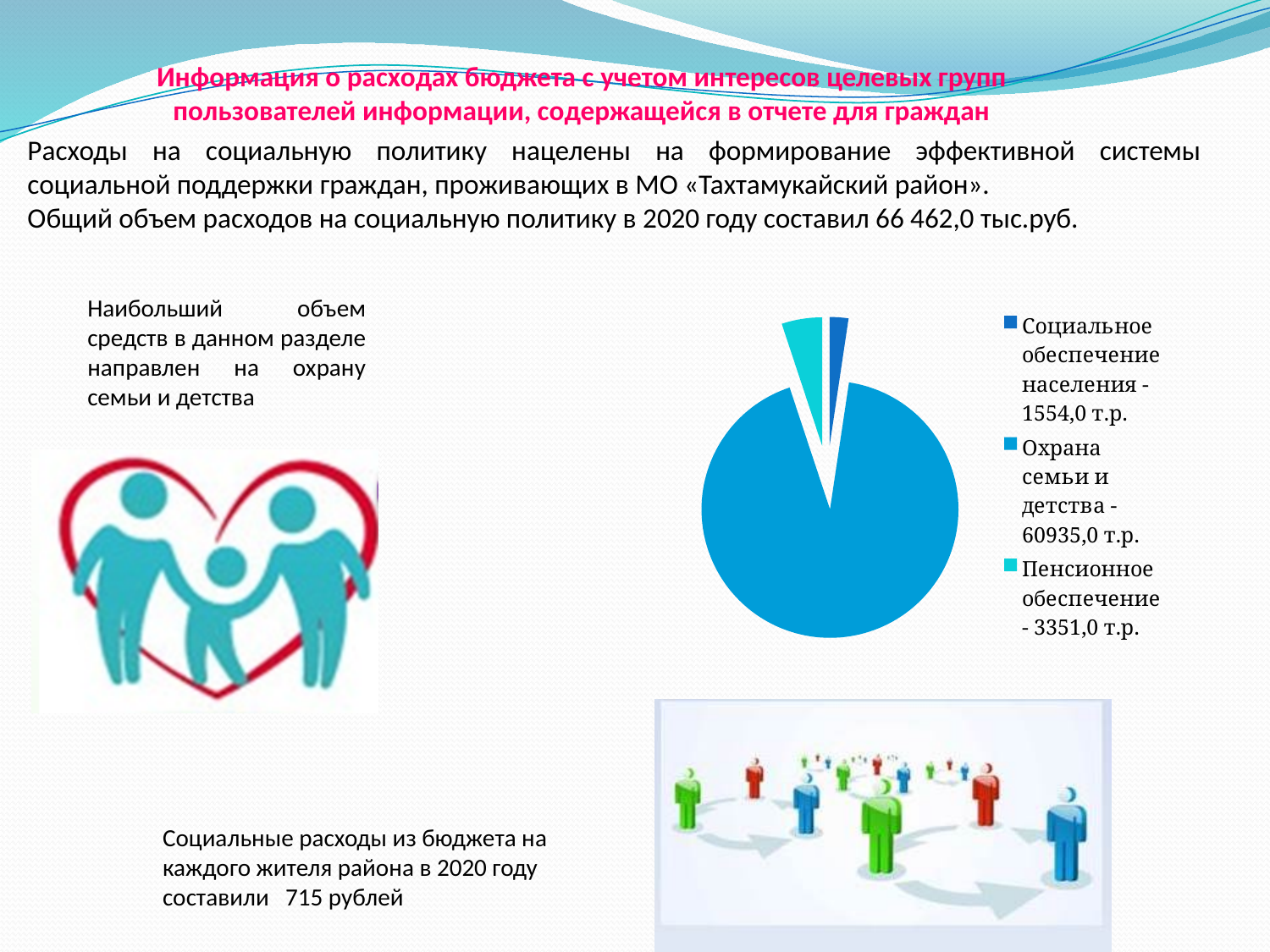
What value does the legend give for Социальное обеспечение населения? 1554,0 т.р. Which category has the smallest slice of the pie chart? Социальное обеспечение населения What is the difference between Пенсионное обеспечение and Социальное обеспечение населения? 1797,0 т.р. How many entries does the legend of the pie chart list? 3 What kind of chart is shown on the slide? pie chart Which category has the largest slice of the pie chart? Охрана семьи и детства What colour is the slice for Пенсионное обеспечение in the pie chart? light blue (cyan) How many slices does the pie chart have? 3 Which is larger: Пенсионное обеспечение or Социальное обеспечение населения? Пенсионное обеспечение What value does the legend give for Охрана семьи и детства? 60935,0 т.р. What is the difference between Охрана семьи и детства and Пенсионное обеспечение? 57584,0 т.р. What value does the legend give for Пенсионное обеспечение? 3351,0 т.р.